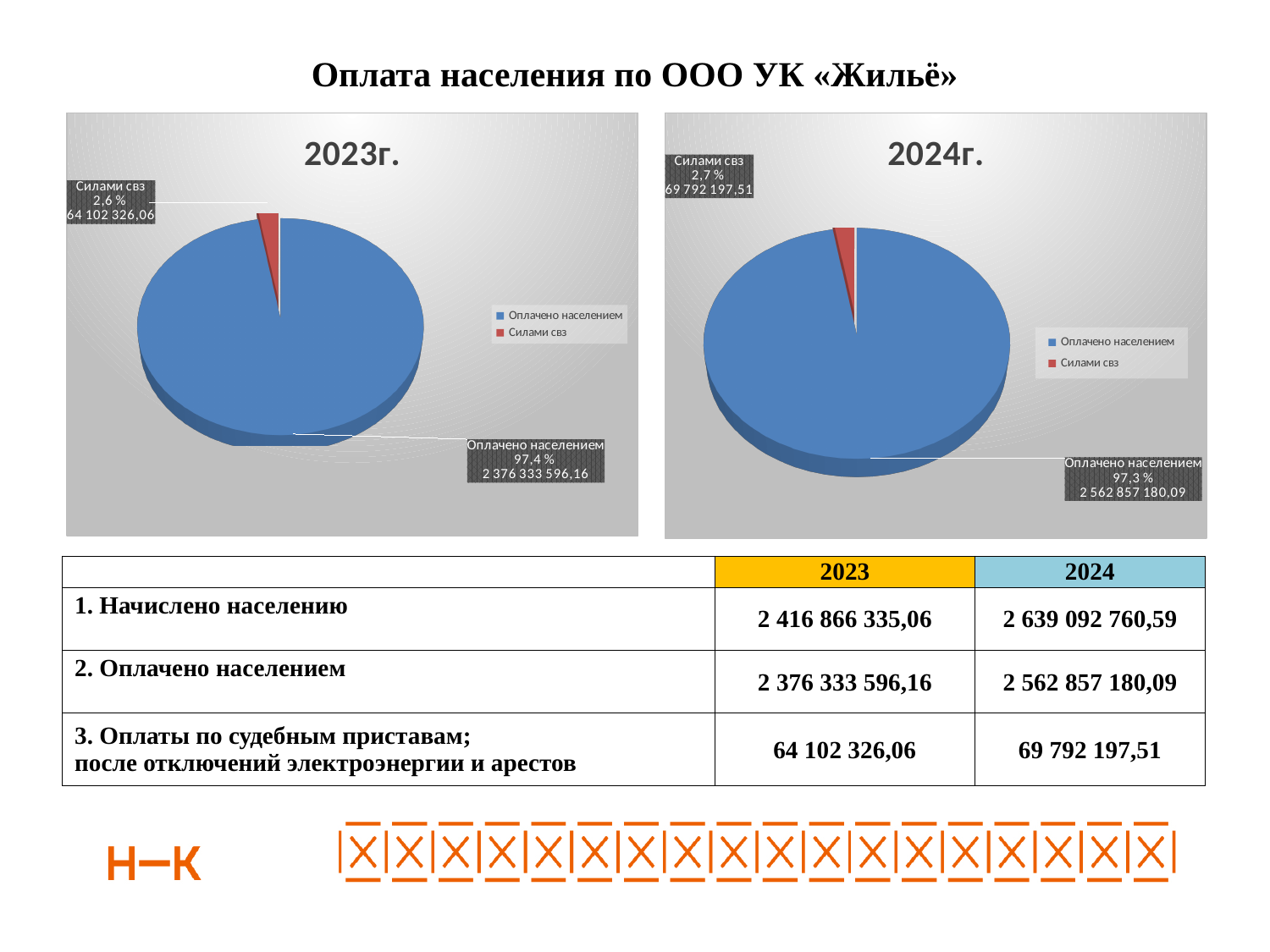
How many entries does the legend of the 2024г. chart list? 2 In the 2023г. pie chart, which slice is the smallest? Силами свз In the 2024г. pie chart, what value is shown for "Силами свз"? 69 792 197,51 In the 2024г. pie chart, what value is shown for "Оплачено населением"? 2 562 857 180,09 In the 2024г. pie chart, which slice is the largest? Оплачено населением What kind of chart is the 2023г. chart? Pie chart In the 2024г. pie chart, what share does the slice "Оплачено населением" have? 97,3 % In the 2023г. pie chart, what share does the slice "Силами свз" have? 2,6 % In the 2024г. pie chart, what share does the slice "Силами свз" have? 2,7 % In the 2023г. pie chart, what value is shown for "Оплачено населением"? 2 376 333 596,16 In the 2023г. pie chart, what value is shown for "Силами свз"? 64 102 326,06